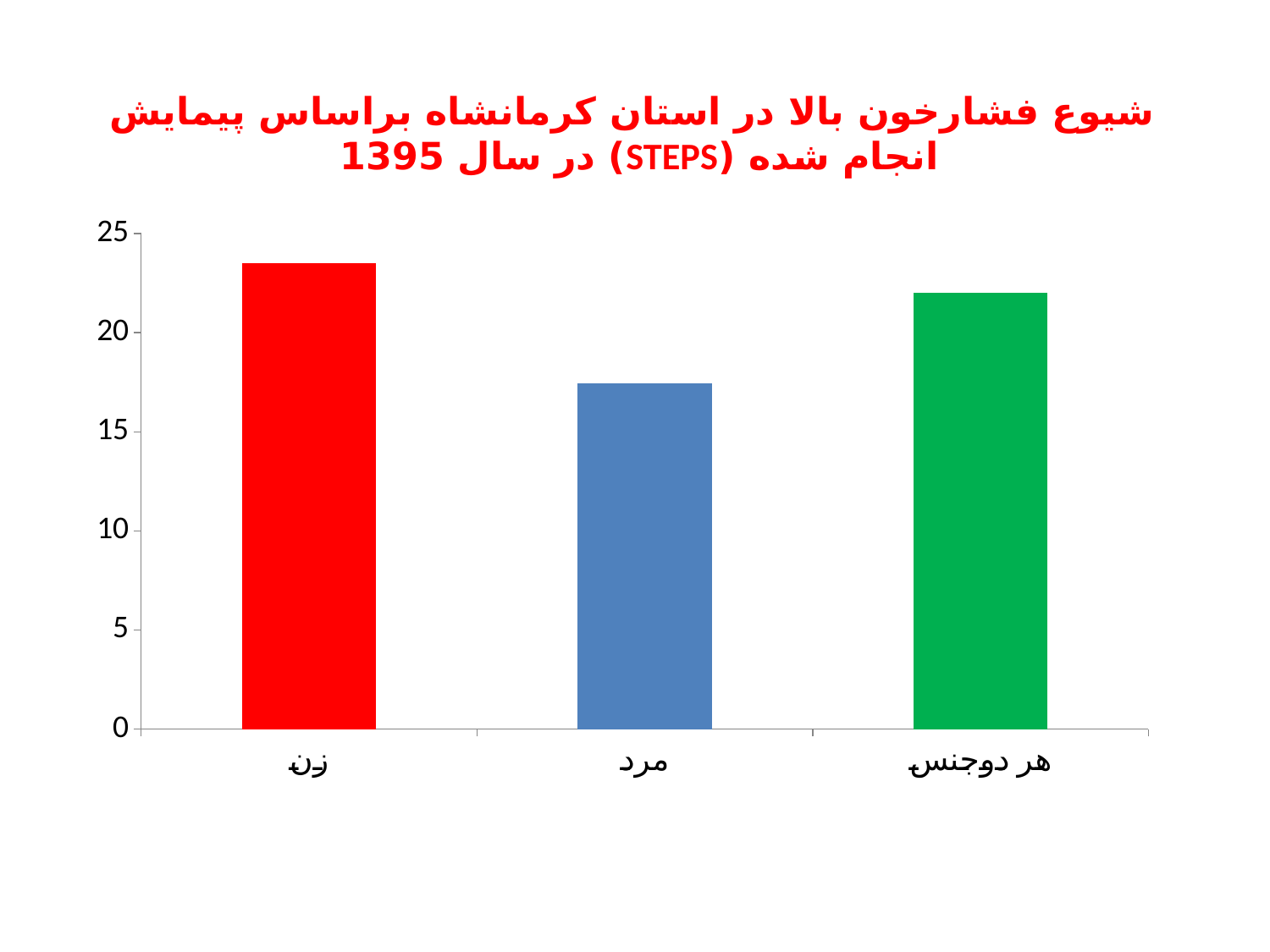
Is the value for مرد greater or less than 20? less Which is larger, the value for زن or the value for مرد? زن How many categories are shown on the x axis of the chart? 3 What colour is the bar for زن? red Which is larger, the value for هر دوجنس or the value for مرد? هر دوجنس Which year does the chart title say the STEPS survey was conducted in? 1395 Is the value for مرد greater or less than 15? greater What kind of chart is shown on the slide? bar chart Is the value for هر دوجنس greater or less than 20? greater Which category has the lowest bar in the chart? مرد Which category has the highest bar in the chart? زن